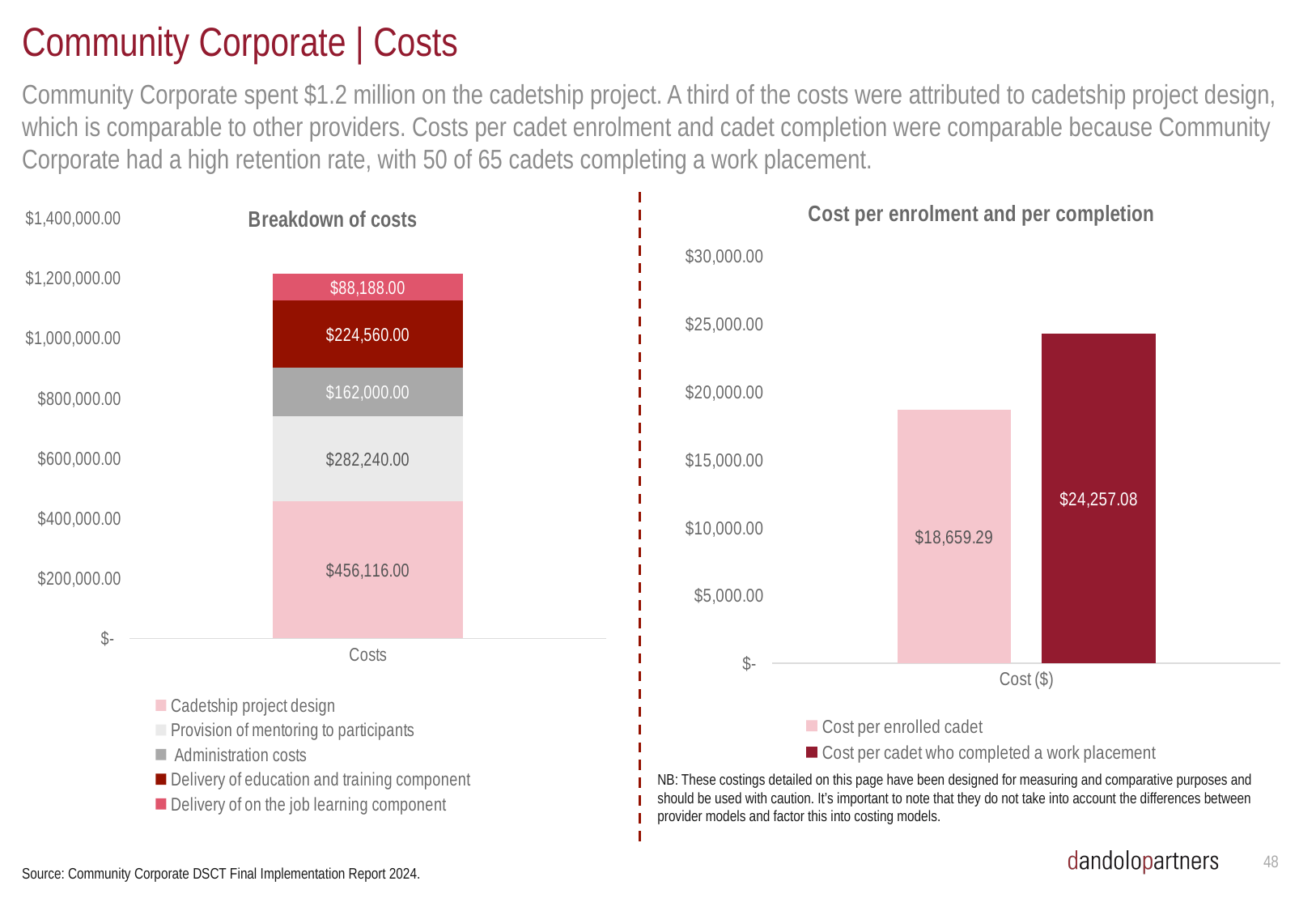
In the 'Breakdown of costs' chart, which cost component is the largest? Cadetship project design How many series does the legend of the 'Breakdown of costs' chart list? 5 In the 'Cost per enrolment and per completion' chart, what is the difference between the cost per cadet who completed a work placement and the cost per enrolled cadet? $5,597.79 In the 'Breakdown of costs' chart, what is the total of the stacked bar? $1,213,104.00 In the 'Breakdown of costs' chart, what is the value for Cadetship project design? $456,116.00 In the 'Cost per enrolment and per completion' chart, what is the cost per enrolled cadet? $18,659.29 What kind of chart is the 'Cost per enrolment and per completion' chart? Bar chart In the 'Breakdown of costs' chart, what is the value for Administration costs? $162,000.00 In the 'Breakdown of costs' chart, what is the difference between Cadetship project design and Provision of mentoring to participants? $173,876.00 In the 'Cost per enrolment and per completion' chart, what is the cost per cadet who completed a work placement? $24,257.08 In the 'Breakdown of costs' chart, which cost component is the smallest? Delivery of on the job learning component In the 'Breakdown of costs' chart, what is the value for Delivery of on the job learning component? $88,188.00